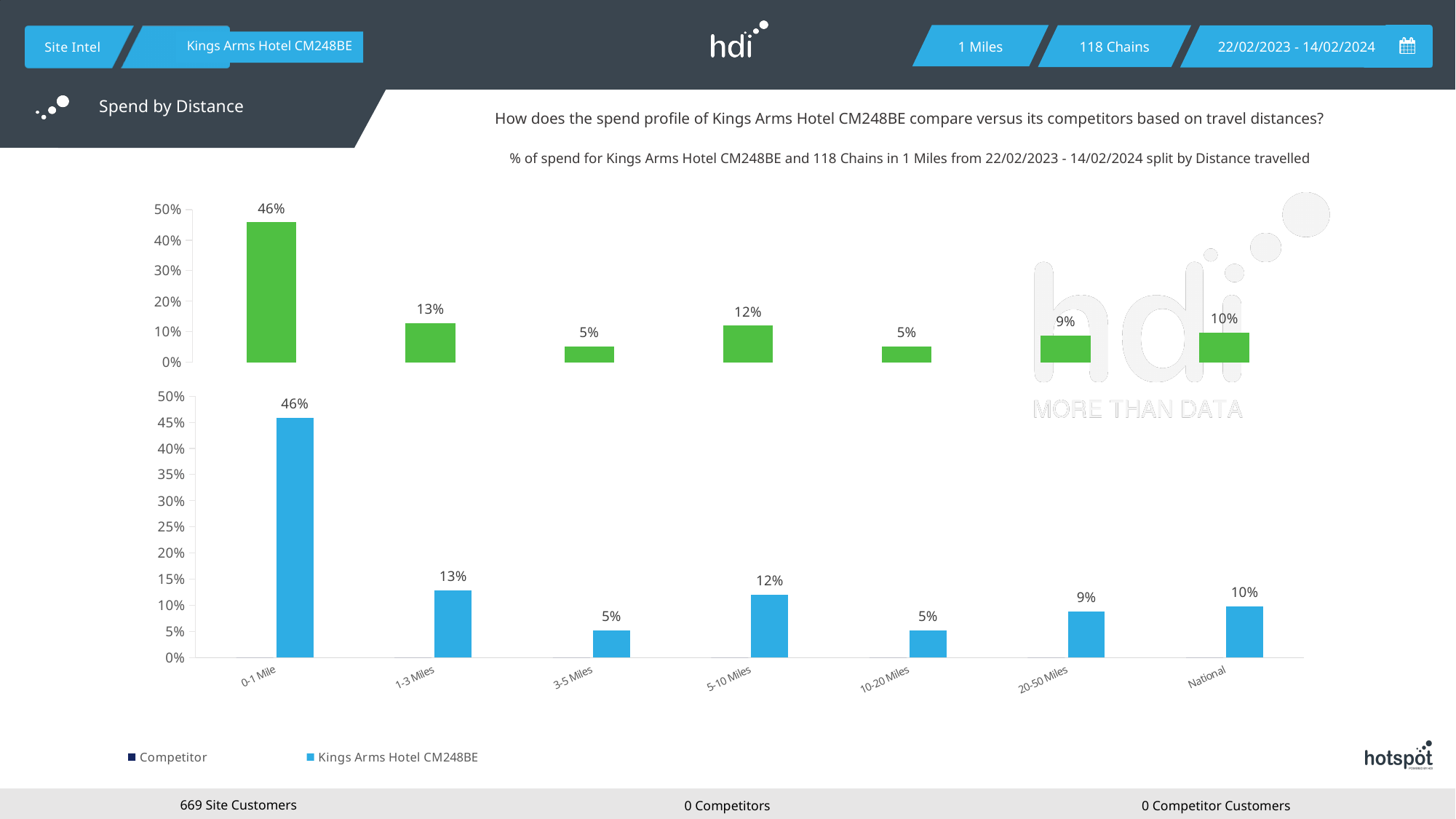
In the bottom chart, which is larger: the value for 20-50 Miles or the value for National? National In the bottom chart, which distance category has the highest value? 0-1 Mile How many distance categories are shown on the x axis of the bottom chart? 7 In the bottom chart, what is the difference between the 0-1 Mile value and the 1-3 Miles value? 33% In the bottom chart, what is the value for Kings Arms Hotel CM248BE in the 0-1 Mile category? 46% In the top chart, what is the value shown on the first (leftmost) bar? 46% In the bottom chart, what is the value for the National category? 10% In the bottom chart, is the value for 1-3 Miles greater or less than 10%? greater In the bottom chart, what is the value for the 5-10 Miles category? 12% How many series does the legend below the bottom chart list? 2 What kind of chart is the bottom chart? bar chart What colour are the bars in the top chart? green